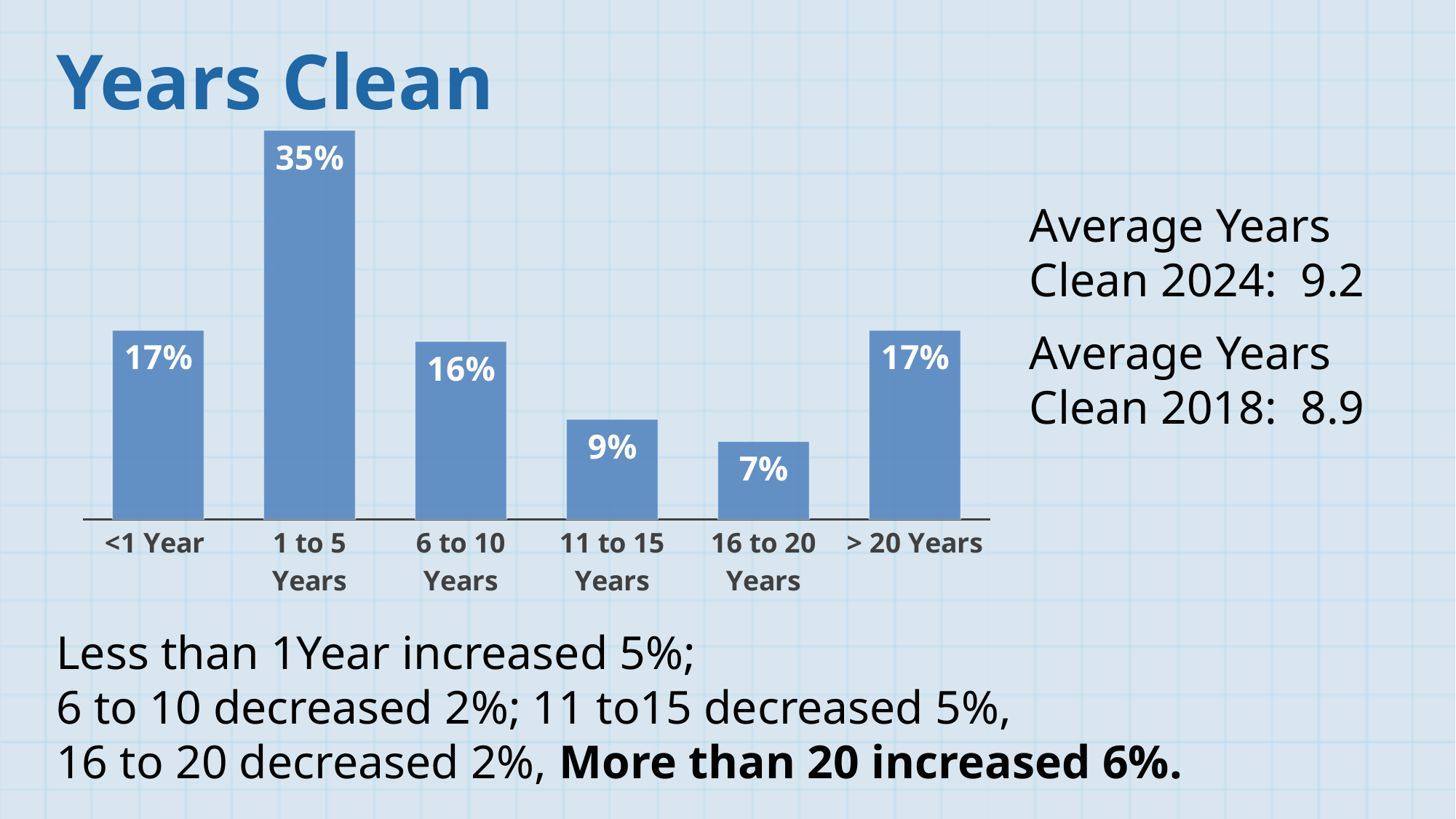
What is the difference between the values for 11 to 15 Years and 16 to 20 Years? 2% What is the value for the 6 to 10 Years category? 16% What is the value for the 11 to 15 Years category? 9% What is the value for the 1 to 5 Years category? 35% Which category has the lowest value? 16 to 20 Years What is the title of the slide containing the chart? Years Clean Which category has the highest value? 1 to 5 Years What kind of chart is shown on the slide? Bar chart What is the value for the 16 to 20 Years category? 7% What is the difference between the values for 1 to 5 Years and 6 to 10 Years? 19% Which is larger, the value for <1 Year or the value for 6 to 10 Years? <1 Year How many categories are shown on the chart? 6